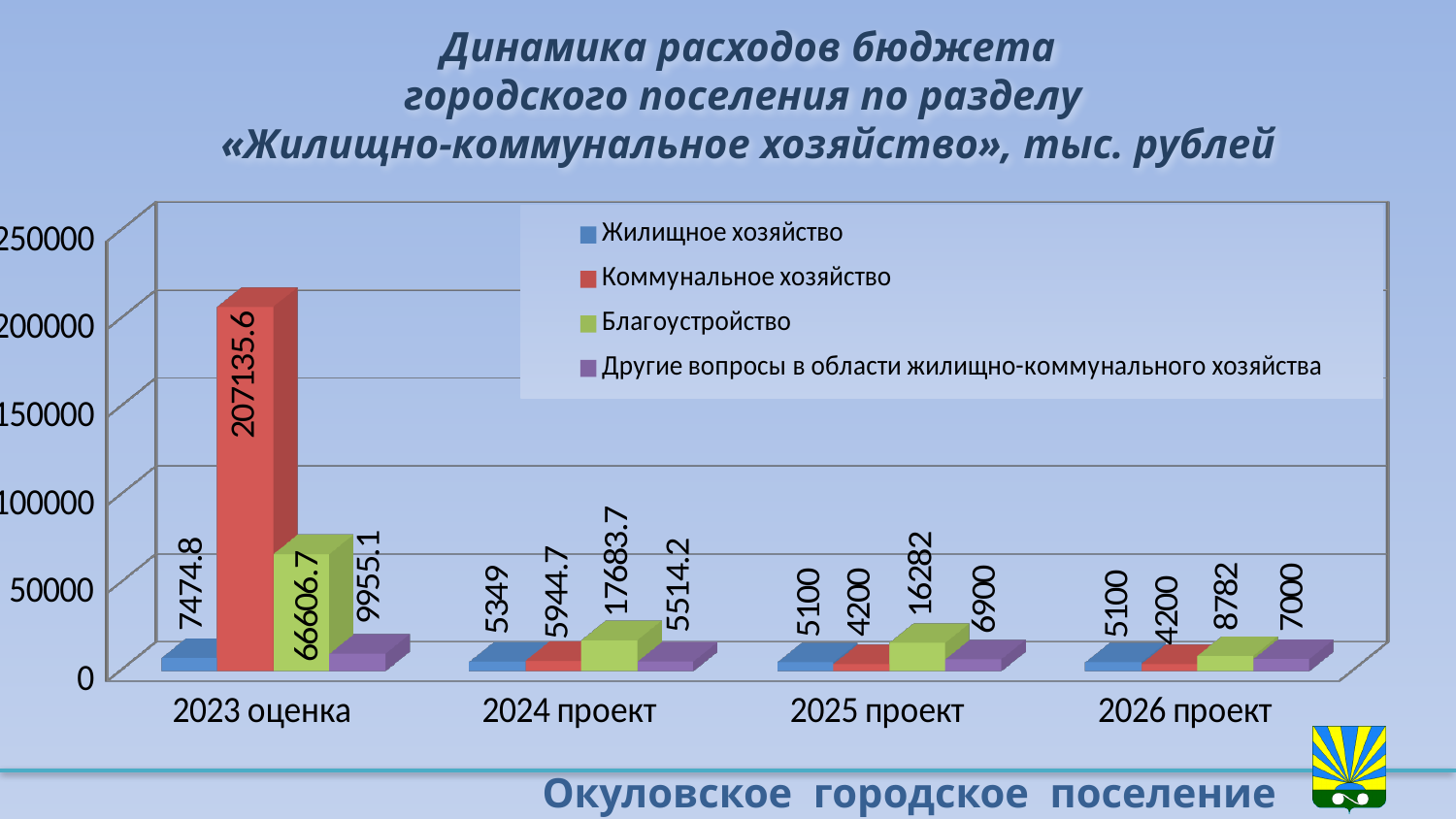
How many series does the legend list? 4 How many year categories are shown on the x axis? 4 Which year has the highest value for Коммунальное хозяйство? 2023 оценка Is the value for Благоустройство in 2023 оценка greater or less than 50000? greater What is the difference between the Благоустройство values for 2025 проект and 2026 проект? 7500 What is the value for Другие вопросы в области жилищно-коммунального хозяйства in 2026 проект? 7000 What is the value for Коммунальное хозяйство in 2023 оценка? 207135.6 What is the value for Благоустройство in 2024 проект? 17683.7 What is the value for Жилищное хозяйство in 2025 проект? 5100 What kind of chart is shown on the slide? Bar chart Which year has the lowest value for Благоустройство? 2026 проект Which is larger in 2024 проект: Жилищное хозяйство or Коммунальное хозяйство? Коммунальное хозяйство